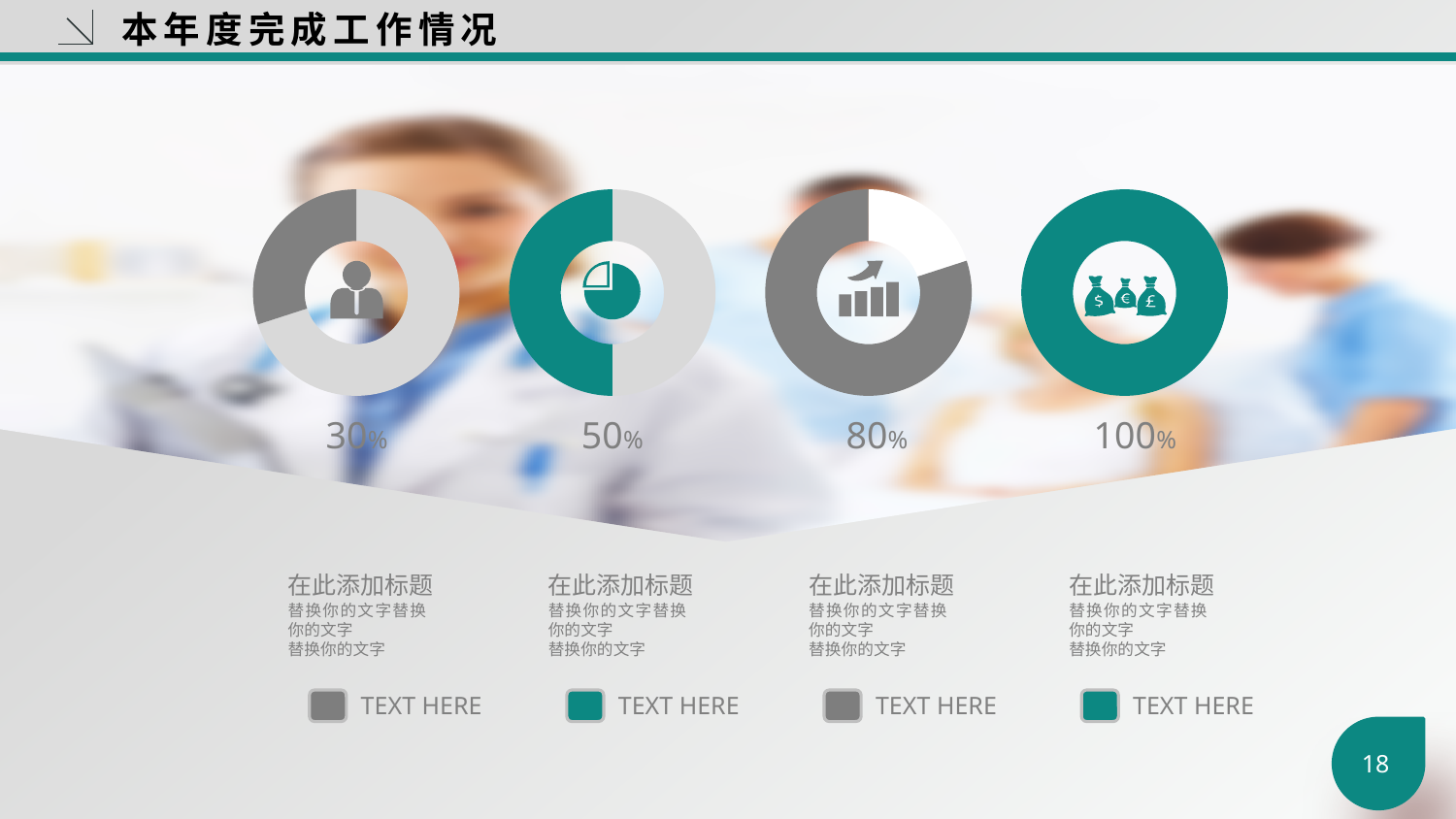
What value is shown below the leftmost donut chart? 30% What kind of charts are used to display the percentages on the slide? donut charts Do the percentages increase or decrease from the leftmost chart to the rightmost chart? increase Which donut chart shows the highest percentage, by position? the rightmost Which donut chart shows the lowest percentage, by position? the leftmost What is the difference between the percentage of the rightmost donut chart and the leftmost donut chart? 70% What value is shown below the rightmost donut chart? 100% Which is larger, the percentage of the second donut chart or the third donut chart? the third donut chart How many donut charts are shown on the slide? 4 What is the difference between the percentage of the third donut chart and the second donut chart? 30% What value is shown below the second donut chart from the left? 50% What value is shown below the third donut chart from the left? 80%